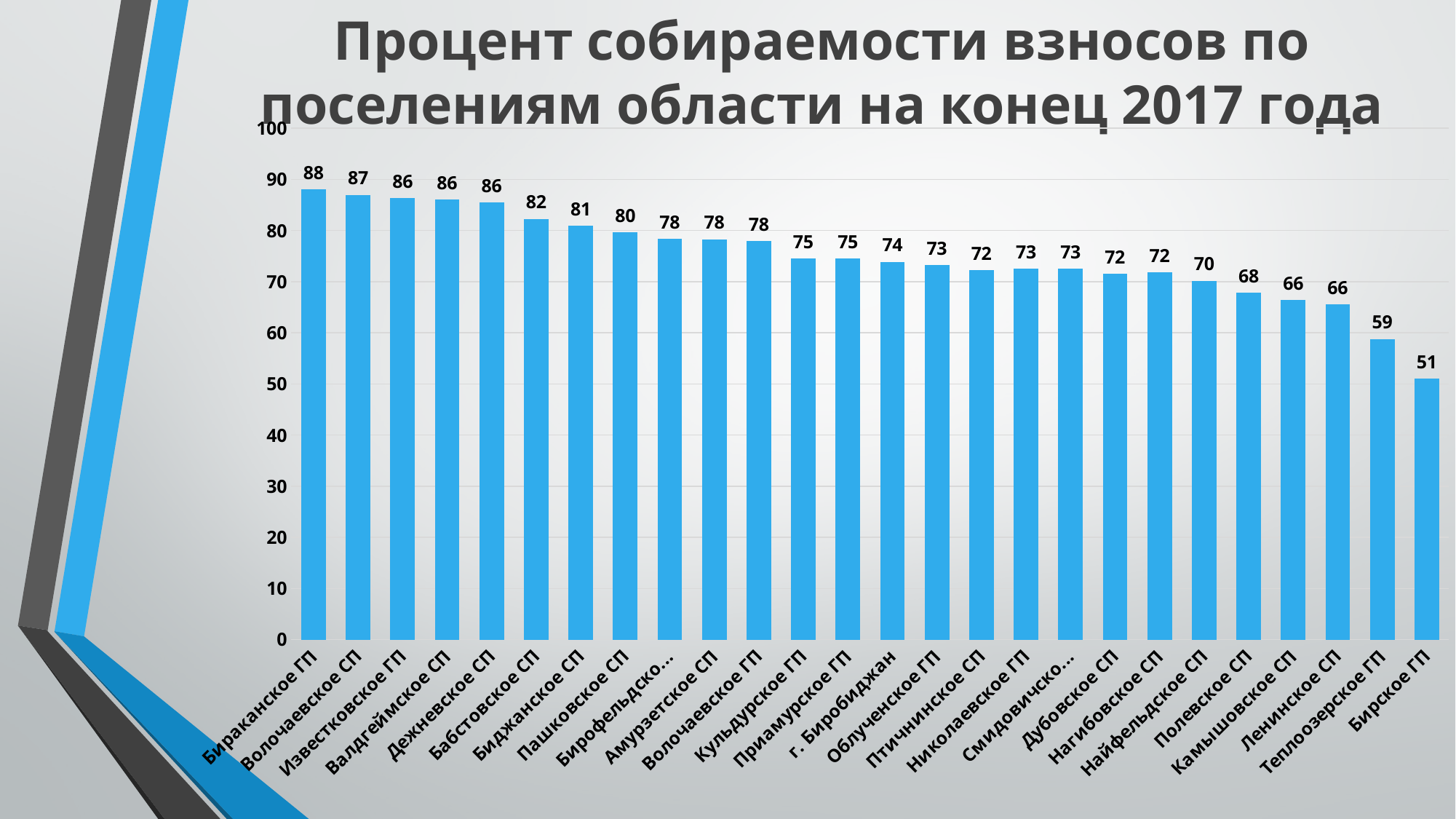
Which category has the highest value? Бираканское ГП What is the title of the chart? Процент собираемости взносов по поселениям области на конец 2017 года Do the values rise or fall from left to right along the x axis? Fall What is the value for Бираканское ГП? 88 How many categories are shown in the chart? 26 Which is larger, the value for Бабстовское СП or the value for Найфельдское СП? Бабстовское СП What is the difference between the values for Бираканское ГП and Бирское ГП? 37 What is the value for Полевское СП? 68 Which category has the lowest value? Бирское ГП What is the value for Теплоозерское ГП? 59 What kind of chart is shown on the slide? Bar chart What is the value for г. Биробиджан? 74